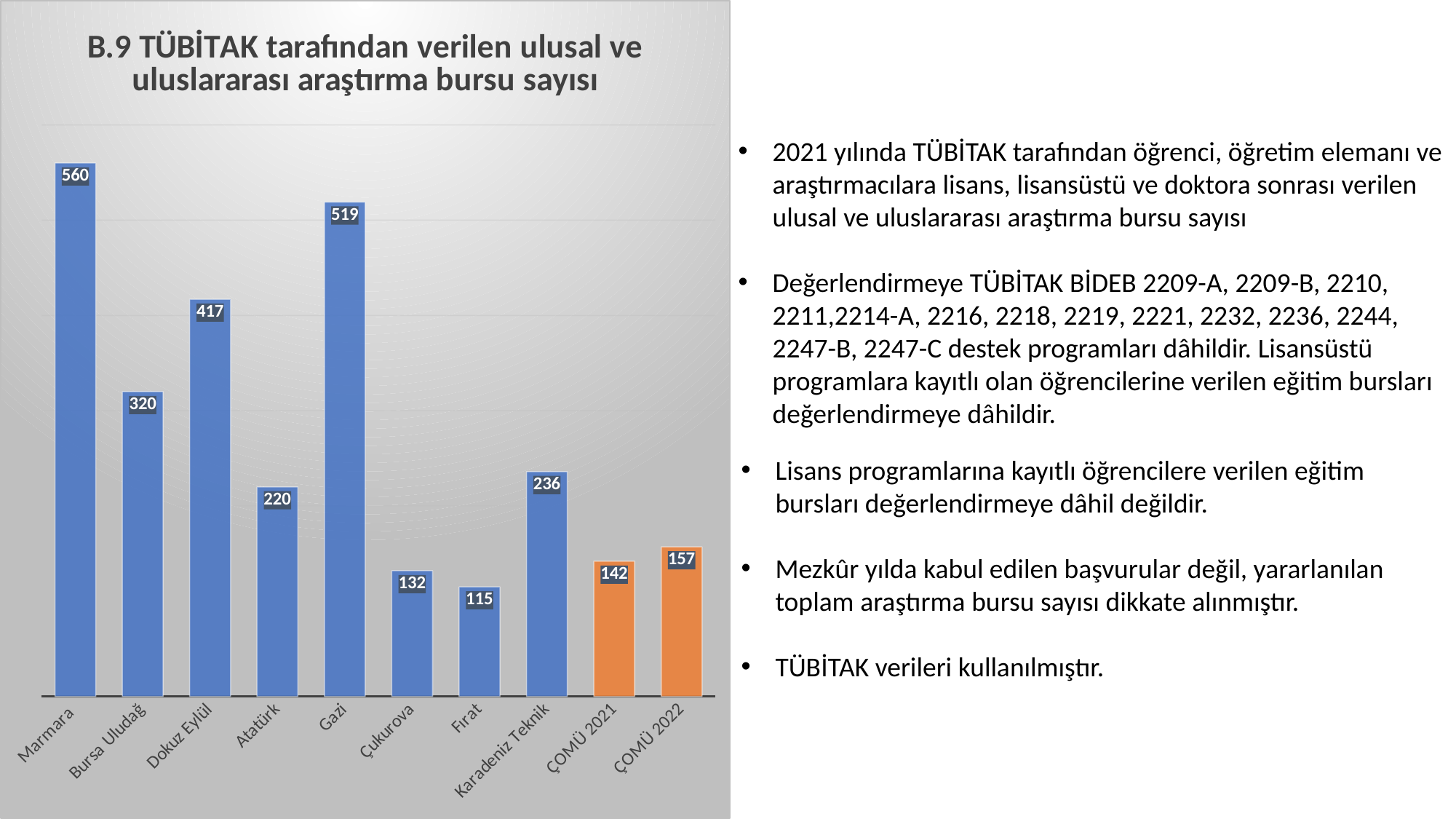
What is the difference between the values for ÇOMÜ 2022 and ÇOMÜ 2021? 15 What is the difference between the values for Dokuz Eylül and Bursa Uludağ? 97 What is the value for Gazi? 519 Which category has the highest value? Marmara Which is larger, the value for Atatürk or the value for Karadeniz Teknik? Karadeniz Teknik What is the value for Karadeniz Teknik? 236 What is the value for ÇOMÜ 2022? 157 What kind of chart is shown on the slide? Bar chart How many categories are shown on the x axis? 10 What is the title of the chart? B.9 TÜBİTAK tarafından verilen ulusal ve uluslararası araştırma bursu sayısı Which category has the lowest value? Fırat What is the value for Marmara? 560